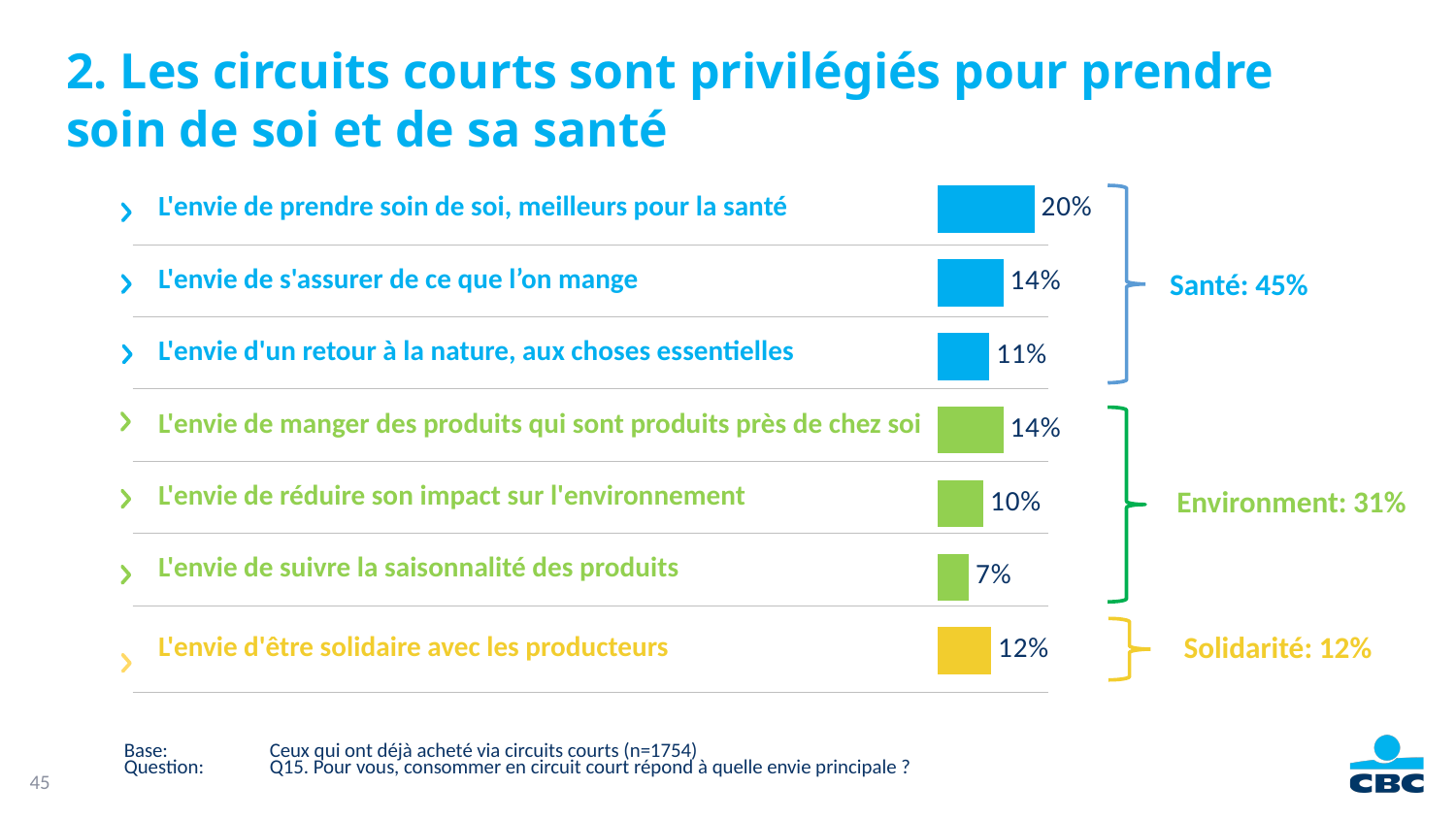
How many categories are shown in the chart? 7 What colour are the bars in the Environment group? Green What is the value for "L'envie d'être solidaire avec les producteurs"? 12% What is the value for "L'envie de suivre la saisonnalité des produits"? 7% What kind of chart is shown on the slide? Bar chart What is the total shown for the Environment group? 31% What is the total shown for the Santé group? 45% What is the value for "L'envie de prendre soin de soi, meilleurs pour la santé"? 20% Which category has the highest value? L'envie de prendre soin de soi, meilleurs pour la santé What is the difference between the values for "L'envie de prendre soin de soi, meilleurs pour la santé" and "L'envie de réduire son impact sur l'environnement"? 10% Which category has the lowest value? L'envie de suivre la saisonnalité des produits Which is larger: the value for "L'envie d'un retour à la nature, aux choses essentielles" or the value for "L'envie d'être solidaire avec les producteurs"? L'envie d'être solidaire avec les producteurs